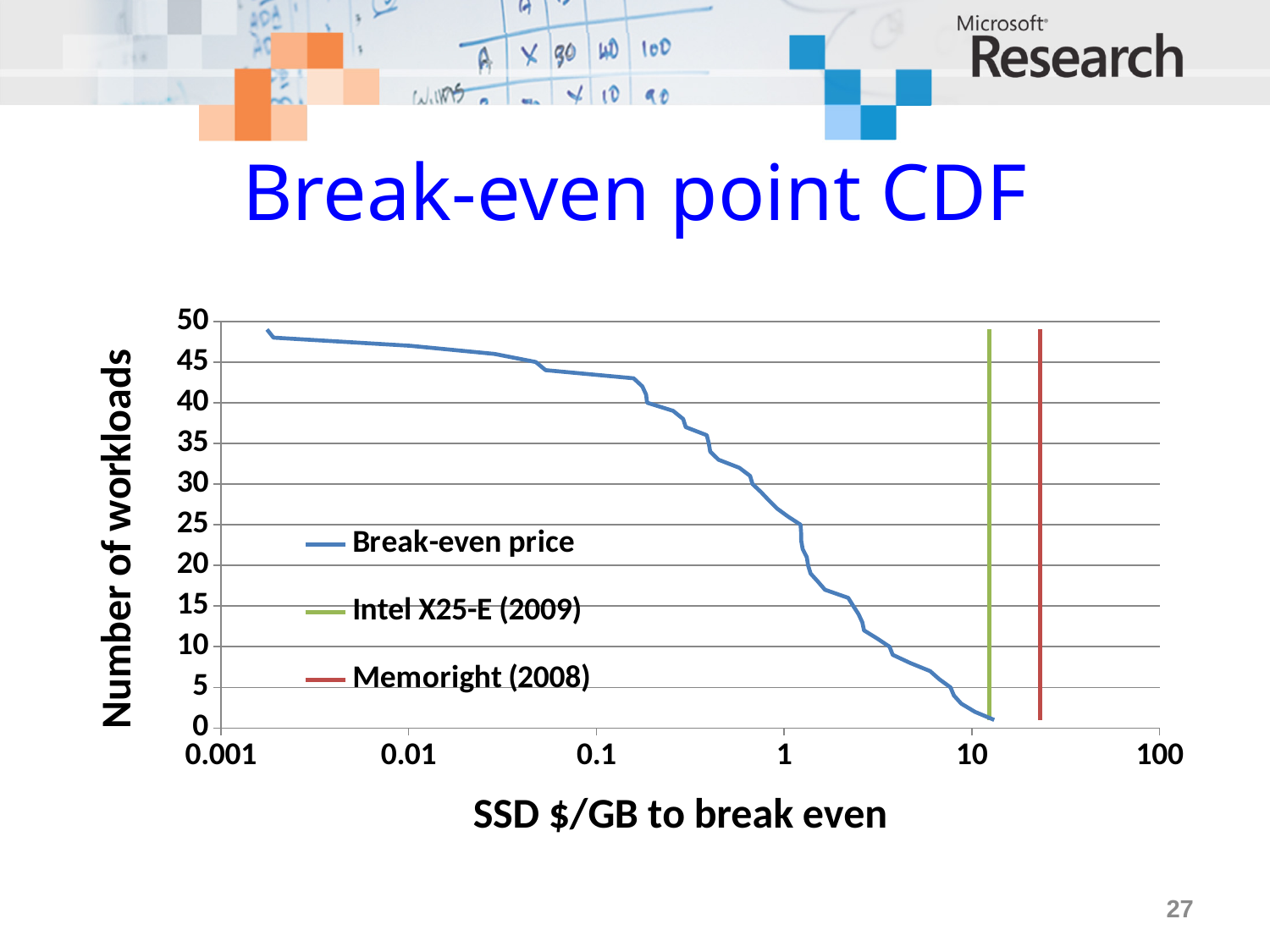
Does the Break-even price curve rise or fall as SSD $/GB increases along the x axis? fall What is the label of the y axis? Number of workloads What kind of chart is shown on the slide? line chart How many series does the chart legend list? 3 Is the SSD $/GB value marked by the Memoright (2008) line greater or less than 100? less What is the title of the chart? Break-even point CDF Is the SSD $/GB value marked by the Intel X25-E (2009) line greater or less than 10? greater At an SSD price of 0.1 $/GB, is the number of workloads on the Break-even price curve greater or less than 40? greater Which has the higher SSD $/GB value, the Intel X25-E (2009) line or the Memoright (2008) line? Memoright (2008)